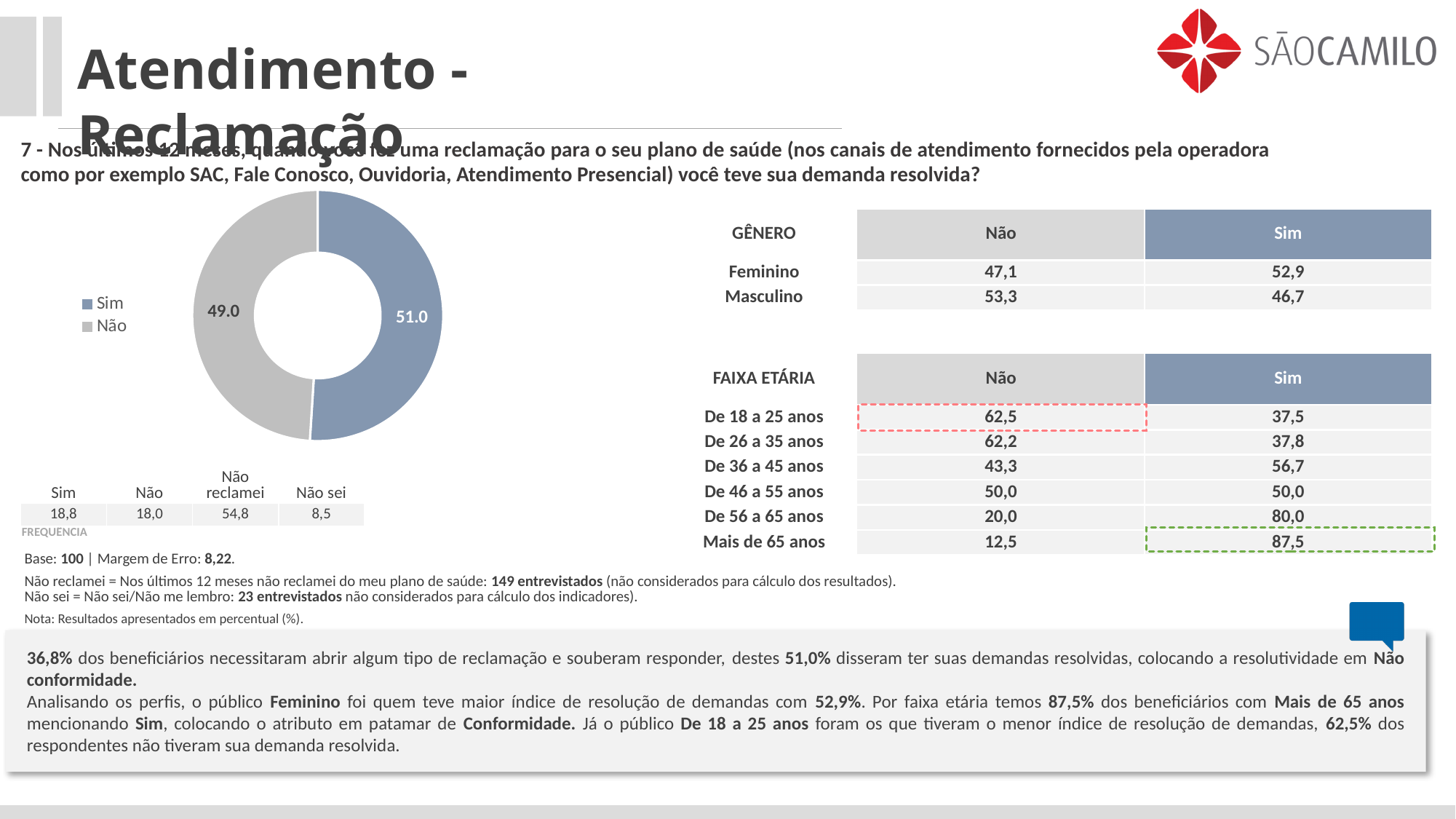
How many entries does the legend of the donut chart list? 2 How many slices does the donut chart have? 2 What kind of chart is shown on the left of the slide? Donut (pie) chart What is the value shown for the "Sim" slice of the donut chart? 51.0 What is the total of the two values shown in the donut chart? 100.0 What colour is the "Não" slice in the donut chart? Gray What is the value shown for the "Não" slice of the donut chart? 49.0 Which slice of the donut chart is the largest? Sim What is the difference between the "Sim" and "Não" values in the donut chart? 2.0 What colour is the "Sim" slice in the donut chart? Blue Which slice of the donut chart is the smallest? Não In the donut chart, which is larger: "Sim" or "Não"? Sim